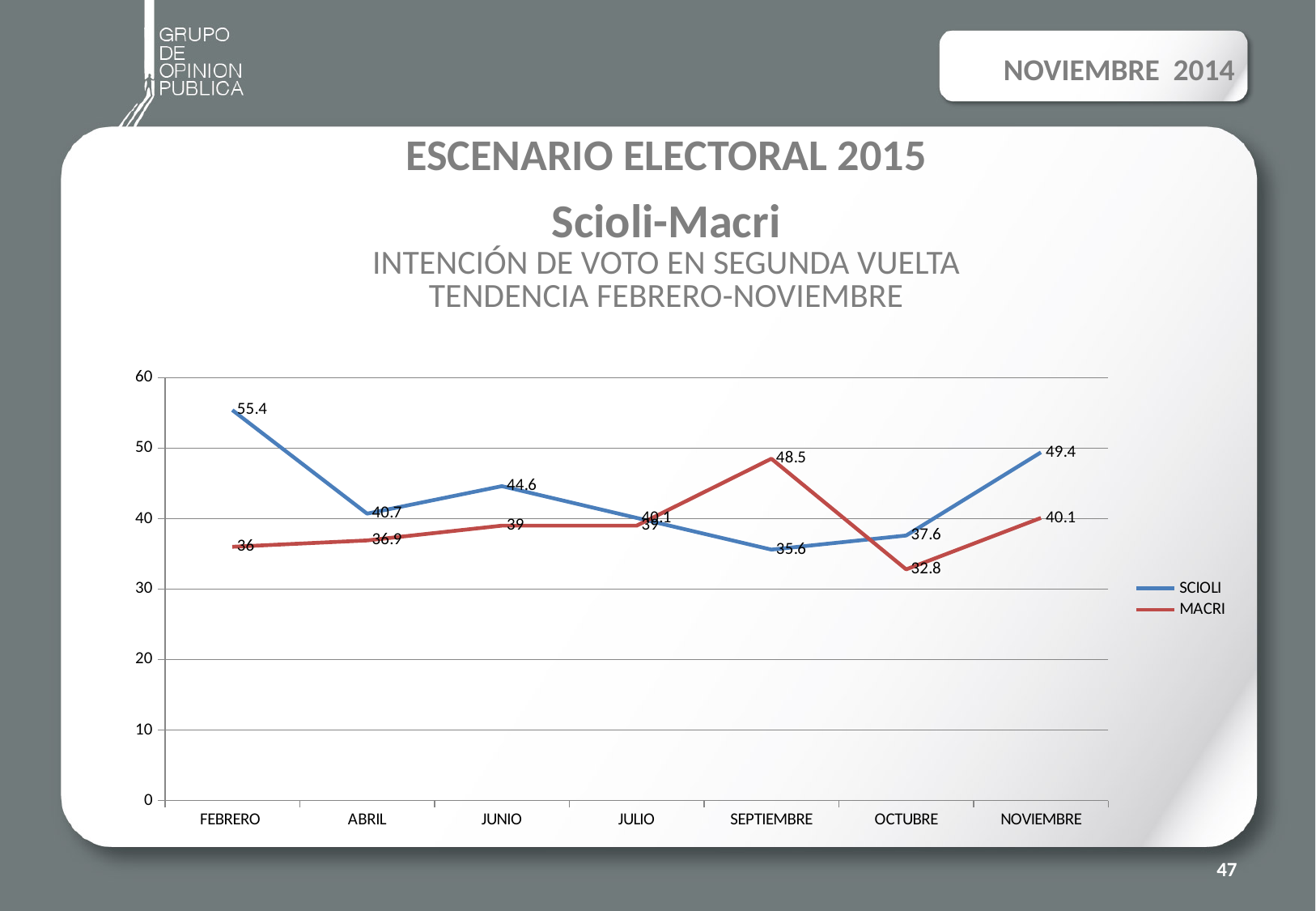
In which month does SCIOLI reach its highest value? FEBRERO Does the MACRI line rise or fall from FEBRERO to JUNIO? Rise What is the difference between SCIOLI and MACRI in NOVIEMBRE? 9.3 What is the value for SCIOLI in FEBRERO? 55.4 What is the value for MACRI in OCTUBRE? 32.8 How many months are shown on the x axis? 7 In which month does MACRI have its lowest value? OCTUBRE What kind of chart is shown on the slide? Line chart Which series has the larger value in SEPTIEMBRE, SCIOLI or MACRI? MACRI What is the value for MACRI in SEPTIEMBRE? 48.5 What is the value for SCIOLI in NOVIEMBRE? 49.4 How many series does the legend list? 2